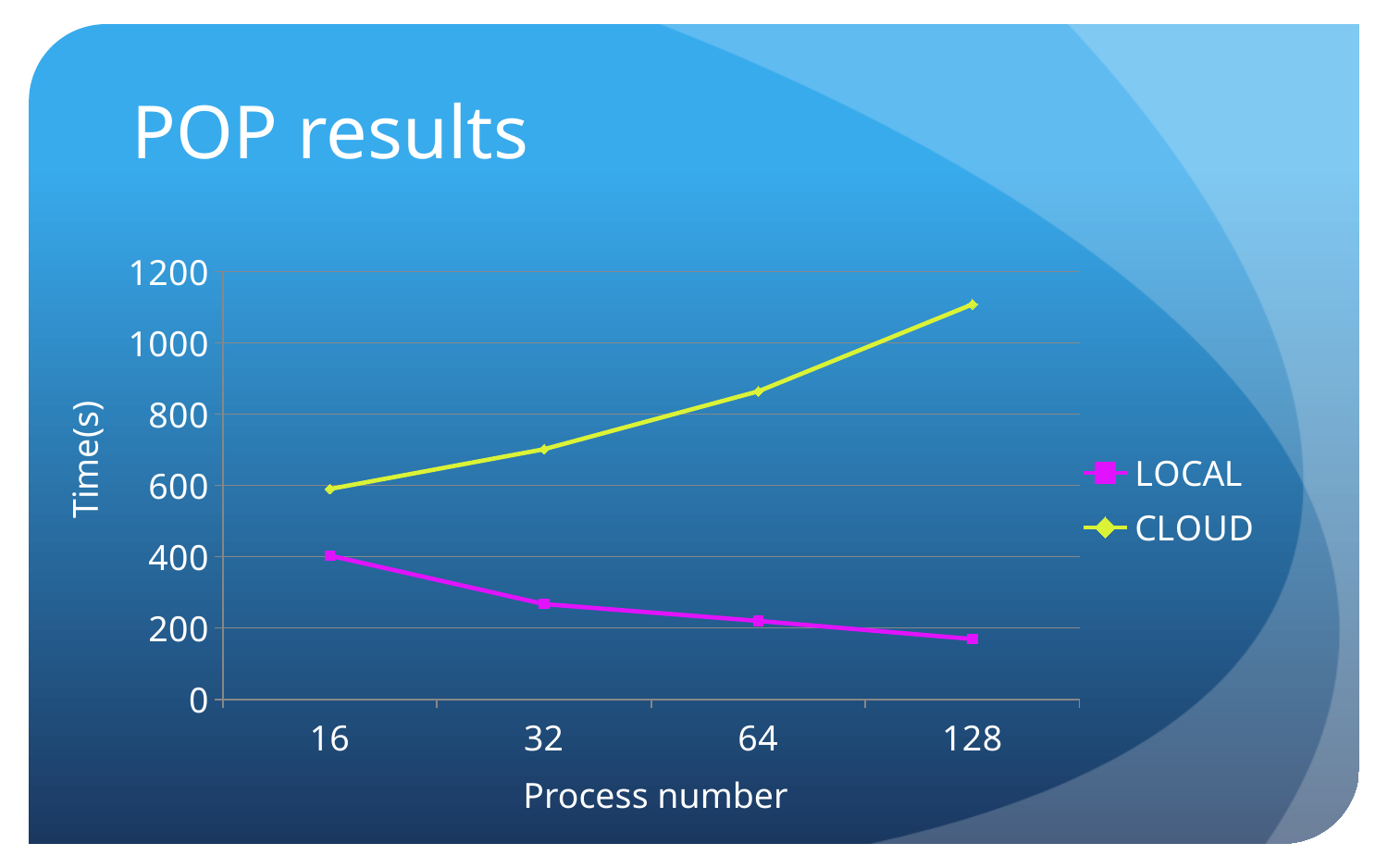
How many series does the legend list? 2 At 64 processes, which series has the larger time, LOCAL or CLOUD? CLOUD Is the CLOUD value at 32 processes greater or less than 600? greater How many process-number points are plotted along the x axis? 4 What kind of chart is shown on the slide? line chart Does the LOCAL series rise or fall as the process number increases? falls Is the CLOUD value at 128 processes greater or less than 1000? greater What is the label of the y axis? Time(s) At which process number does the CLOUD series reach its highest time? 128 Is the LOCAL value at 128 processes greater or less than 200? less What is the title of the chart? POP results Does the CLOUD series rise or fall as the process number increases? rises